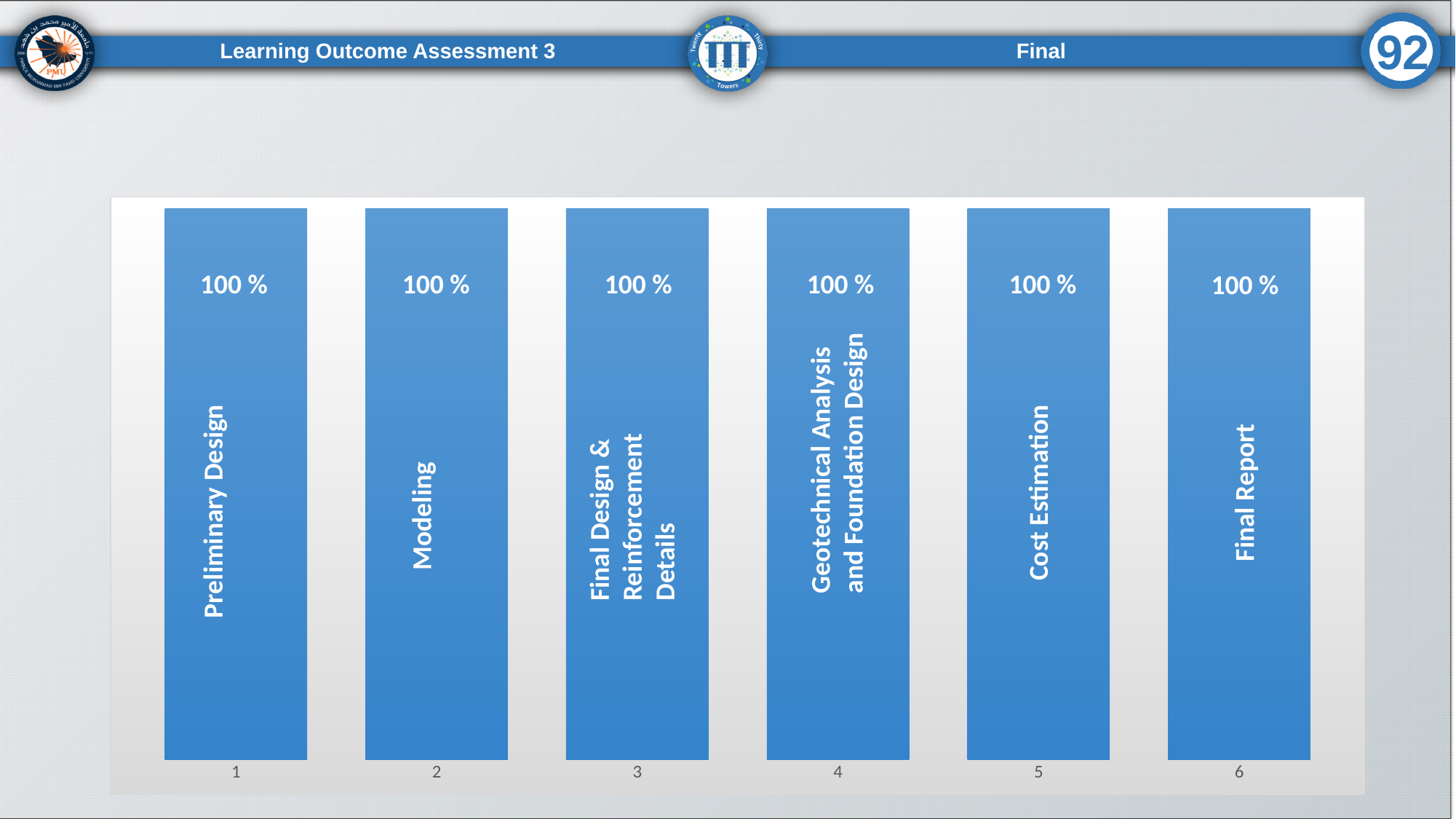
What value is shown for Cost Estimation? 100 % What value is shown for Preliminary Design? 100 % How many bars are plotted in the chart? 6 What kind of chart is shown on the slide? Bar chart What is the difference between the values for Preliminary Design and Final Report? 0 % What value is shown for Final Report? 100 % What value is shown for Modeling? 100 % What value is shown for Geotechnical Analysis and Foundation Design? 100 % Do the values rise, fall, or stay the same across the bars from left to right? Stay the same Which category label is written inside the bar at x-axis position 6? Final Report Which category label is written inside the bar at x-axis position 3? Final Design & Reinforcement Details